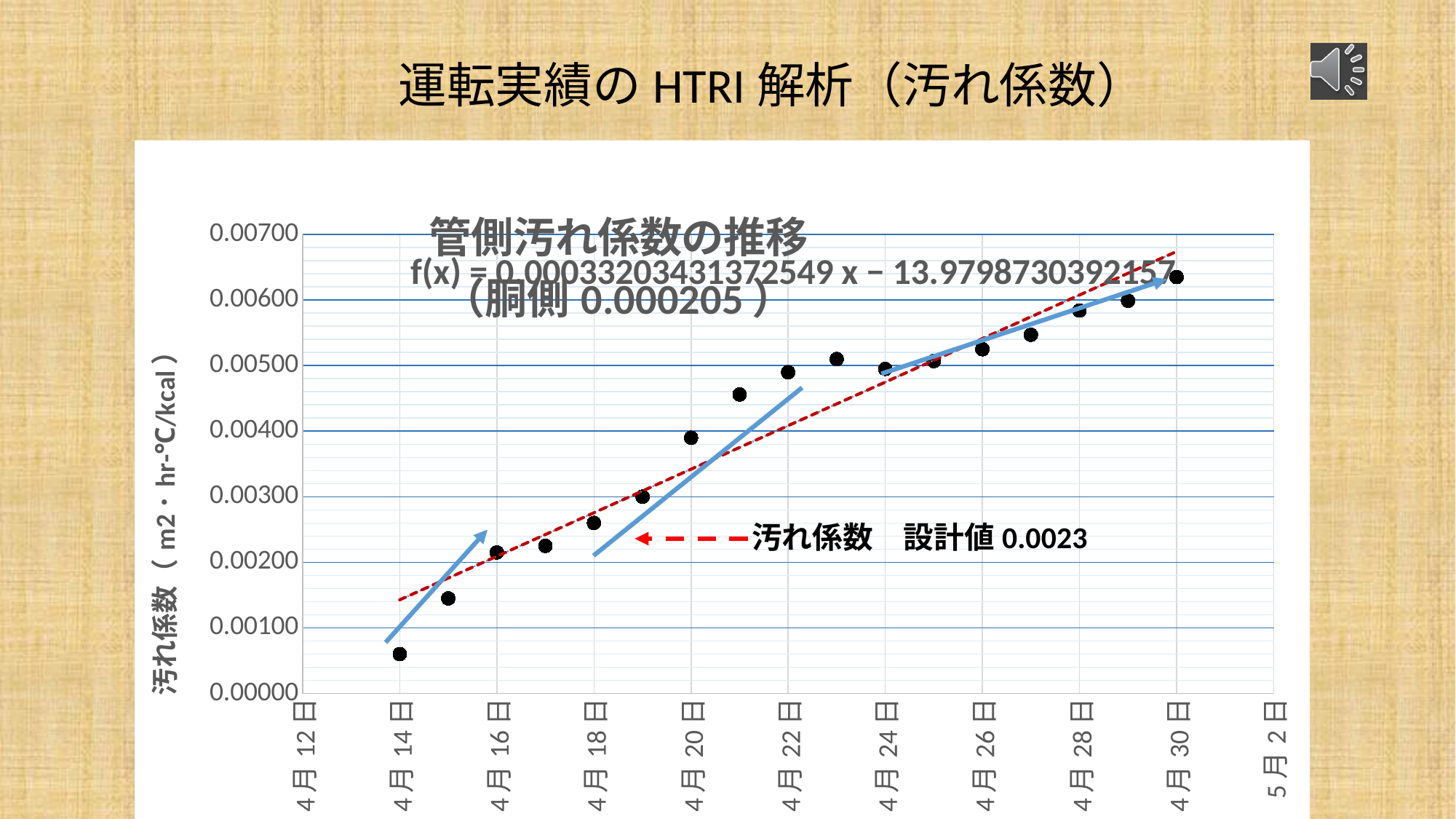
Which is larger, the value for 4月16日 or the value for 4月26日? 4月26日 Is the value for 4月28日 greater or less than 0.00500? greater On which date is the plotted fouling factor highest? 4月30日 Do the plotted fouling factor values rise or fall from 4月14日 to 4月30日? Rise Is the value for 4月18日 greater or less than 0.00200? greater Is the value for 4月30日 greater or less than 0.00600? greater What kind of chart is shown on the slide? Scatter chart What is the title of the chart? 管側汚れ係数の推移（胴側 0.000205） On which date is the plotted fouling factor lowest? 4月14日 What design value (設計値) for the fouling factor is annotated on the chart? 0.0023